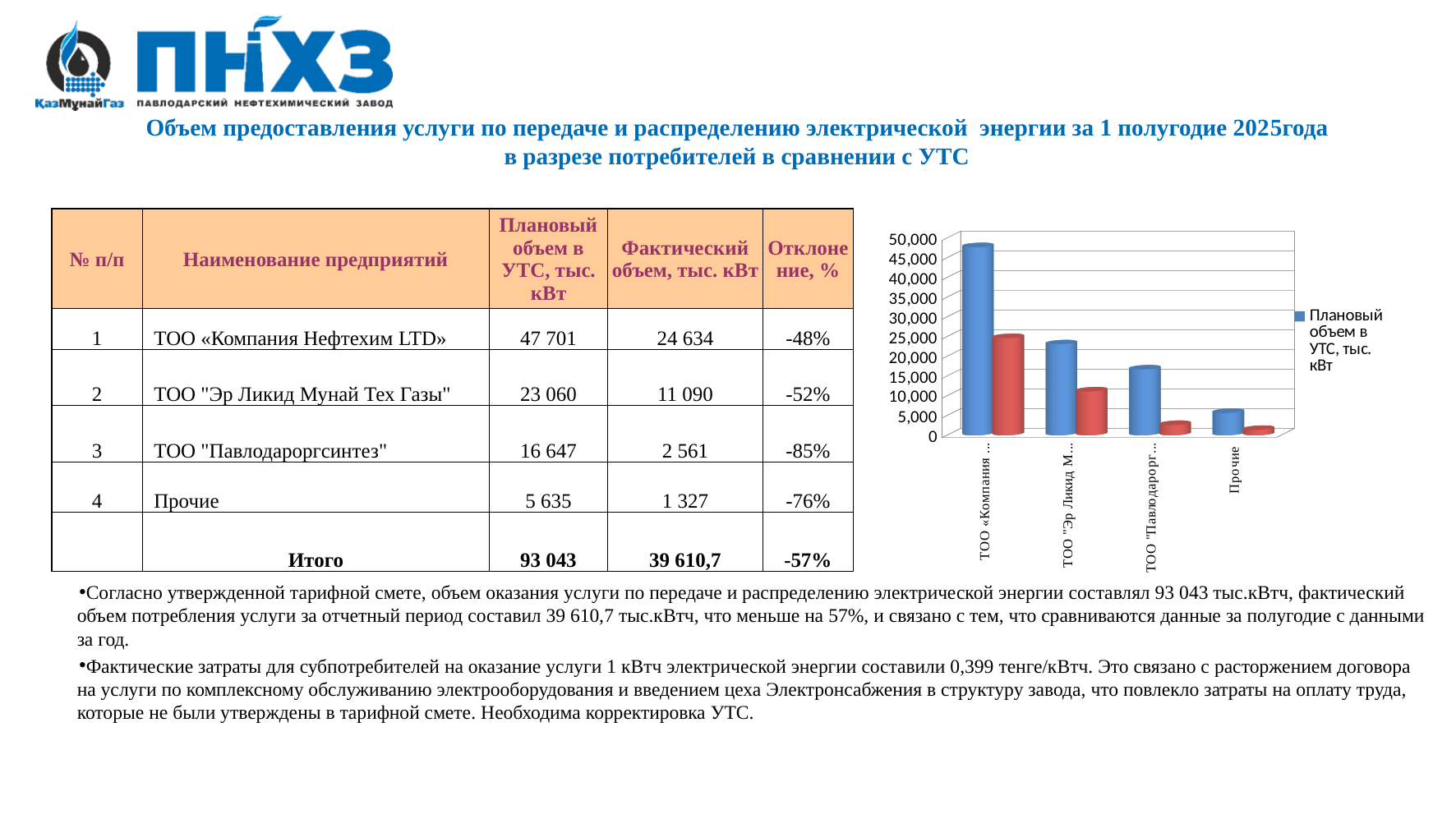
For ТОО "Эр Ликид Мунай Тех Газы", which is larger: the planned volume or the actual volume? Planned volume Do the planned volumes (blue bars) rise or fall from left to right across the categories? Fall How many consumer categories are plotted on the x axis of the chart? 4 Is the planned volume (blue bar) for ТОО «Компания Нефтехим LTD» greater or less than 45,000? greater What is the actual volume for ТОО "Эр Ликид Мунай Тех Газы", in thousand kWh? 11 090 Is the actual volume (red bar) for ТОО "Павлодароргсинтез" greater or less than 5,000? less By how much does the planned volume exceed the actual volume for ТОО «Компания Нефтехим LTD», in thousand kWh? 23 067 Which category has the lowest planned volume (blue bar) in the chart? Прочие What kind of chart is shown on the right of the slide? Bar chart Is the planned volume (blue bar) for Прочие greater or less than 10,000? less What is the planned volume in УТС for ТОО "Павлодароргсинтез", in thousand kWh? 16 647 Which category has the highest planned volume (blue bar) in the chart? ТОО «Компания Нефтехим LTD»